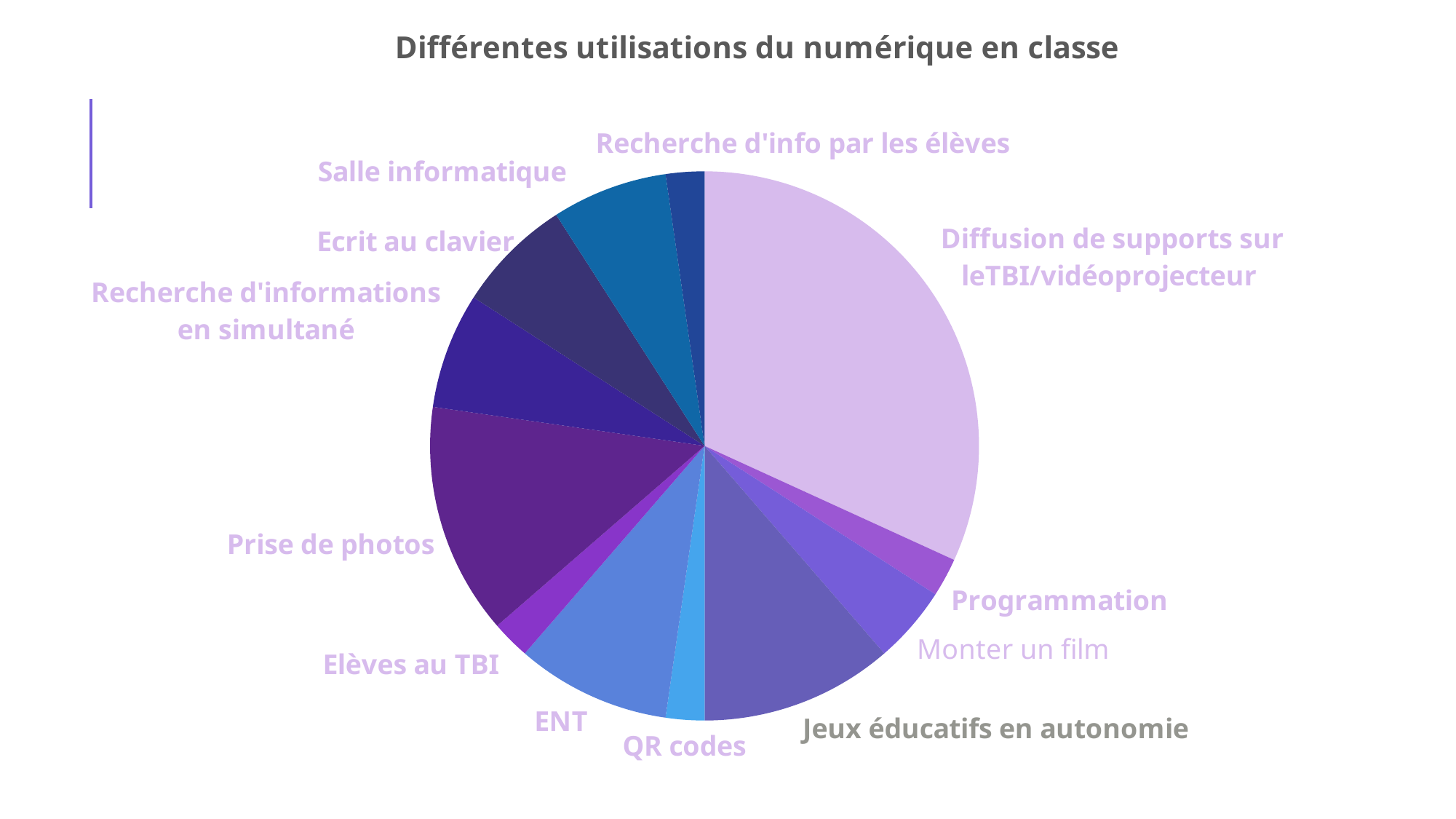
Which slice is larger, Diffusion de supports sur le TBI/vidéoprojecteur or Prise de photos? Diffusion de supports sur le TBI/vidéoprojecteur Which slice is larger, ENT or Elèves au TBI? ENT What is the title of the chart? Différentes utilisations du numérique en classe What kind of chart is shown on the slide? Pie chart Which slice is larger, Salle informatique or QR codes? Salle informatique Which category has the largest slice of the pie? Diffusion de supports sur le TBI/vidéoprojecteur Which category label is written in dark grey rather than purple? Jeux éducatifs en autonomie How many categories (slices) does the pie chart have? 12